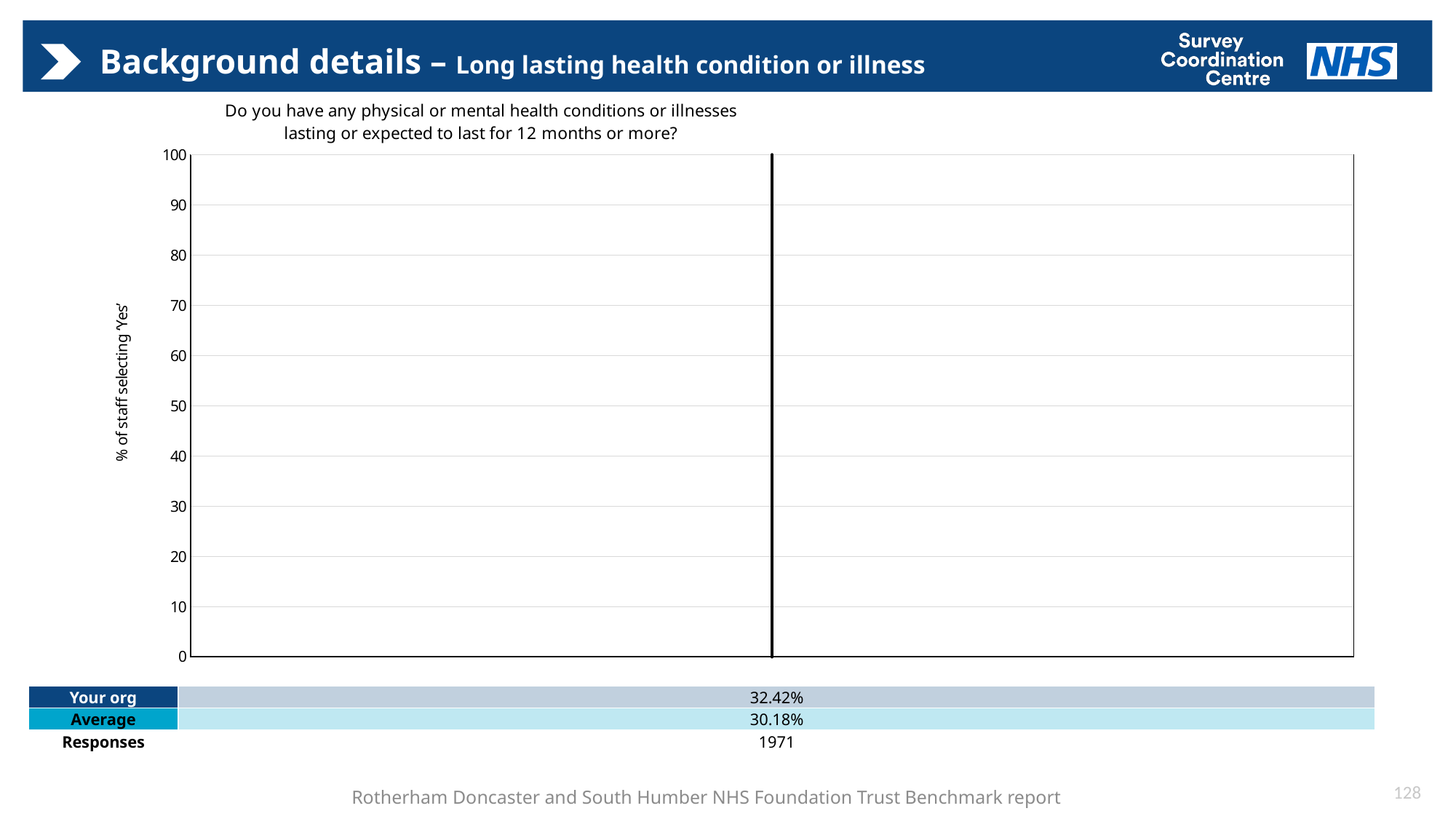
Which is larger, the Your org value or the Average value? Your org What is the label on the vertical axis of the chart? % of staff selecting 'Yes' How many responses are shown in the data table below the chart? 1971 What is the title of the chart? Do you have any physical or mental health conditions or illnesses lasting or expected to last for 12 months or more? Is the Your org value greater or less than 30? greater What is the Average value shown in the data table below the chart? 30.18% Is the Average value greater or less than 40? less What is the value for Your org shown in the data table below the chart? 32.42% What is the difference between the Your org value and the Average value? 2.24% What is the maximum value shown on the vertical axis of the chart? 100